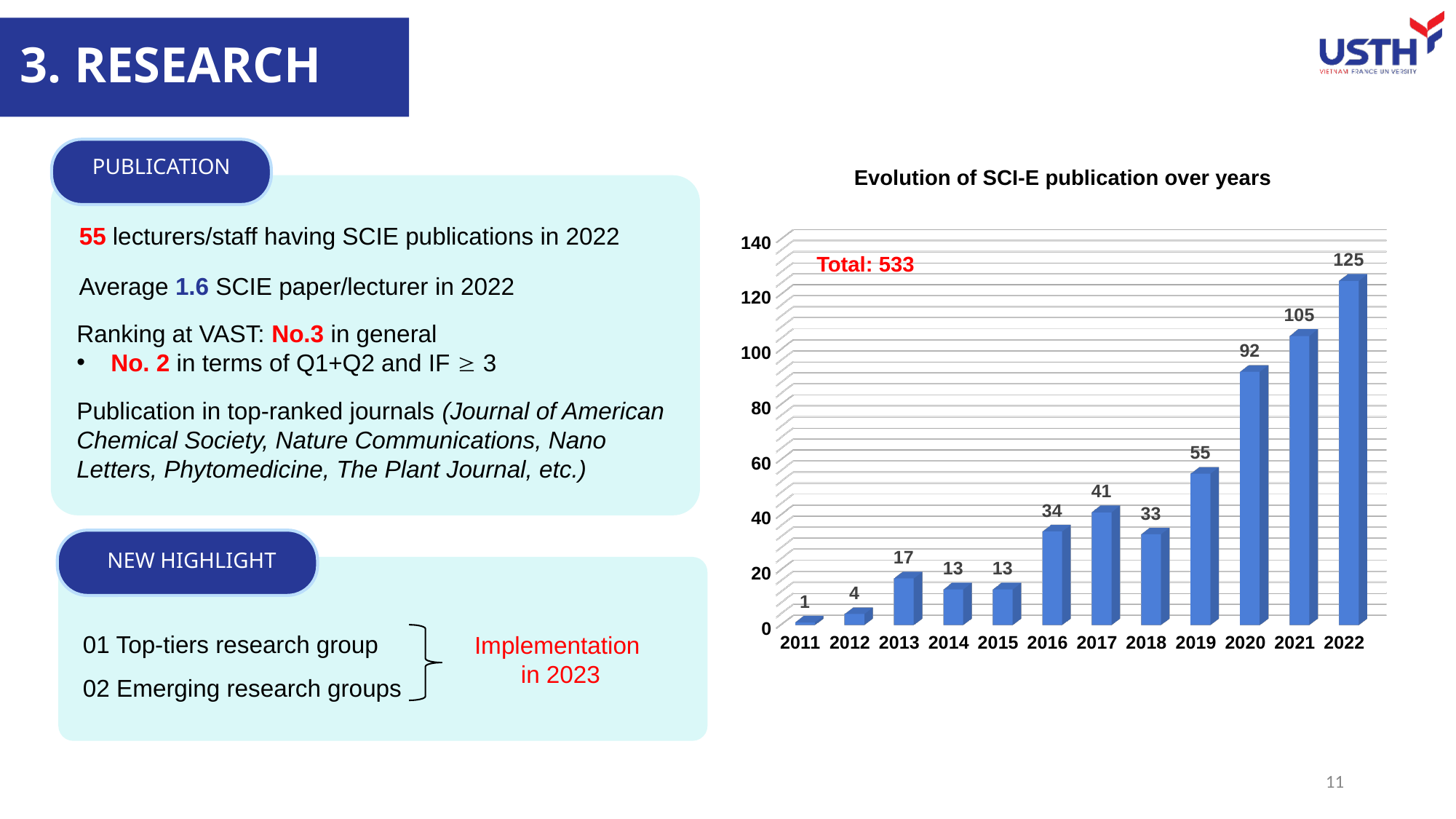
Is the value for 2020 greater or less than 80? greater What is the value for 2011 in the chart? 1 What is the value for 2022 in the chart? 125 How many years are shown on the x axis of the chart? 12 Which is larger, the value for 2017 or the value for 2018? 2017 What kind of chart is shown on the slide? bar chart What is the difference between the values for 2019 and 2018? 22 What is the title of the chart? Evolution of SCI-E publication over years What is the difference between the values for 2022 and 2021? 20 Which year has the lowest number of SCI-E publications? 2011 Which year has the highest number of SCI-E publications? 2022 What is the value for 2016 in the chart? 34